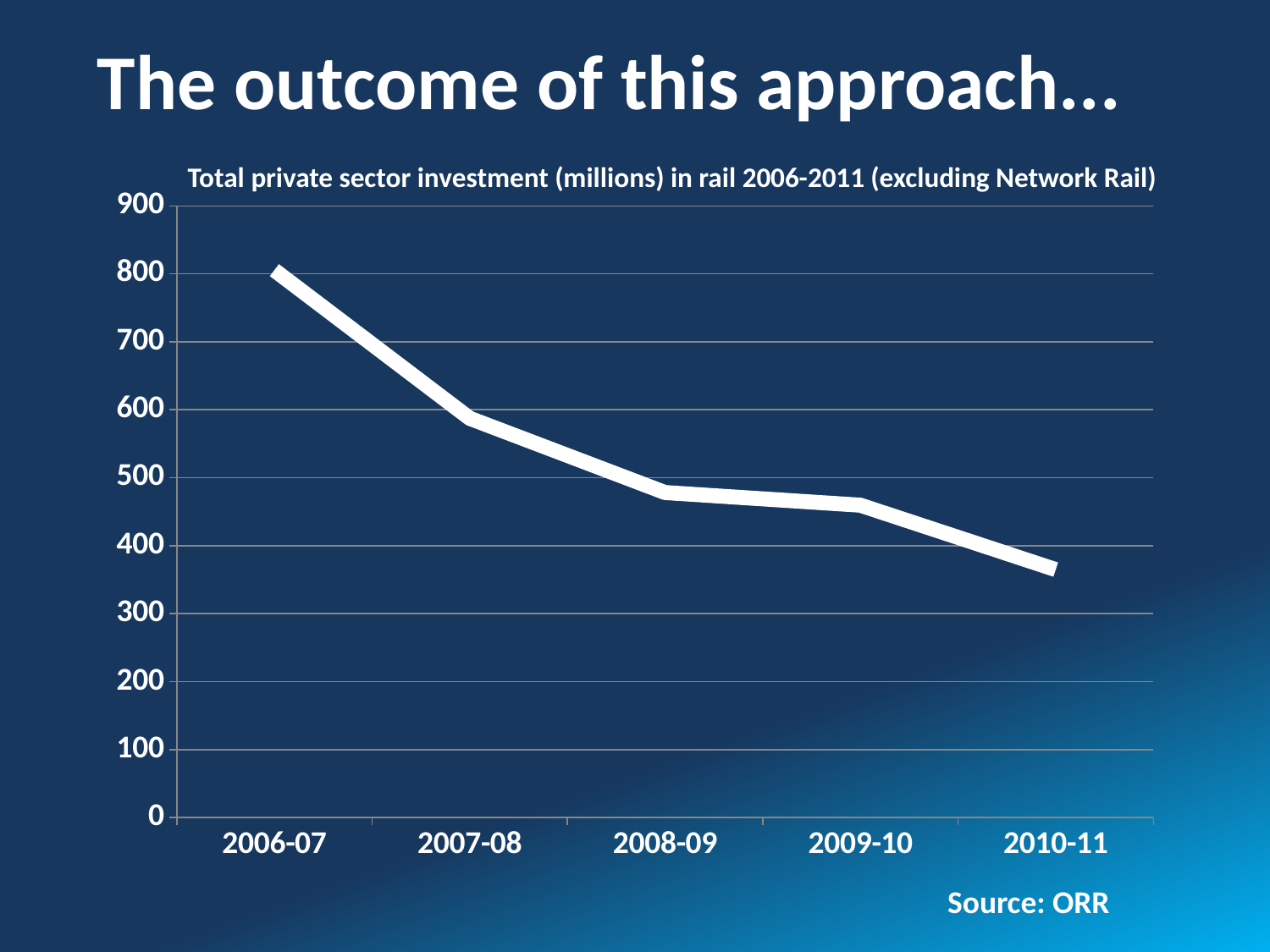
Is the value for 2008-09 greater or less than 500? less How many years are plotted on the x axis of the chart? 5 Is the value for 2010-11 greater or less than 400? less Which year has the lowest private sector investment in the chart? 2010-11 What is the title of the chart? Total private sector investment (millions) in rail 2006-2011 (excluding Network Rail) Is the value for 2006-07 greater or less than 700? greater Which year has the highest private sector investment in the chart? 2006-07 What source is cited for the chart data? ORR What kind of chart is shown on the slide? line chart Do the values rise or fall from 2006-07 to 2010-11? fall Which is larger, the value for 2006-07 or the value for 2010-11? 2006-07